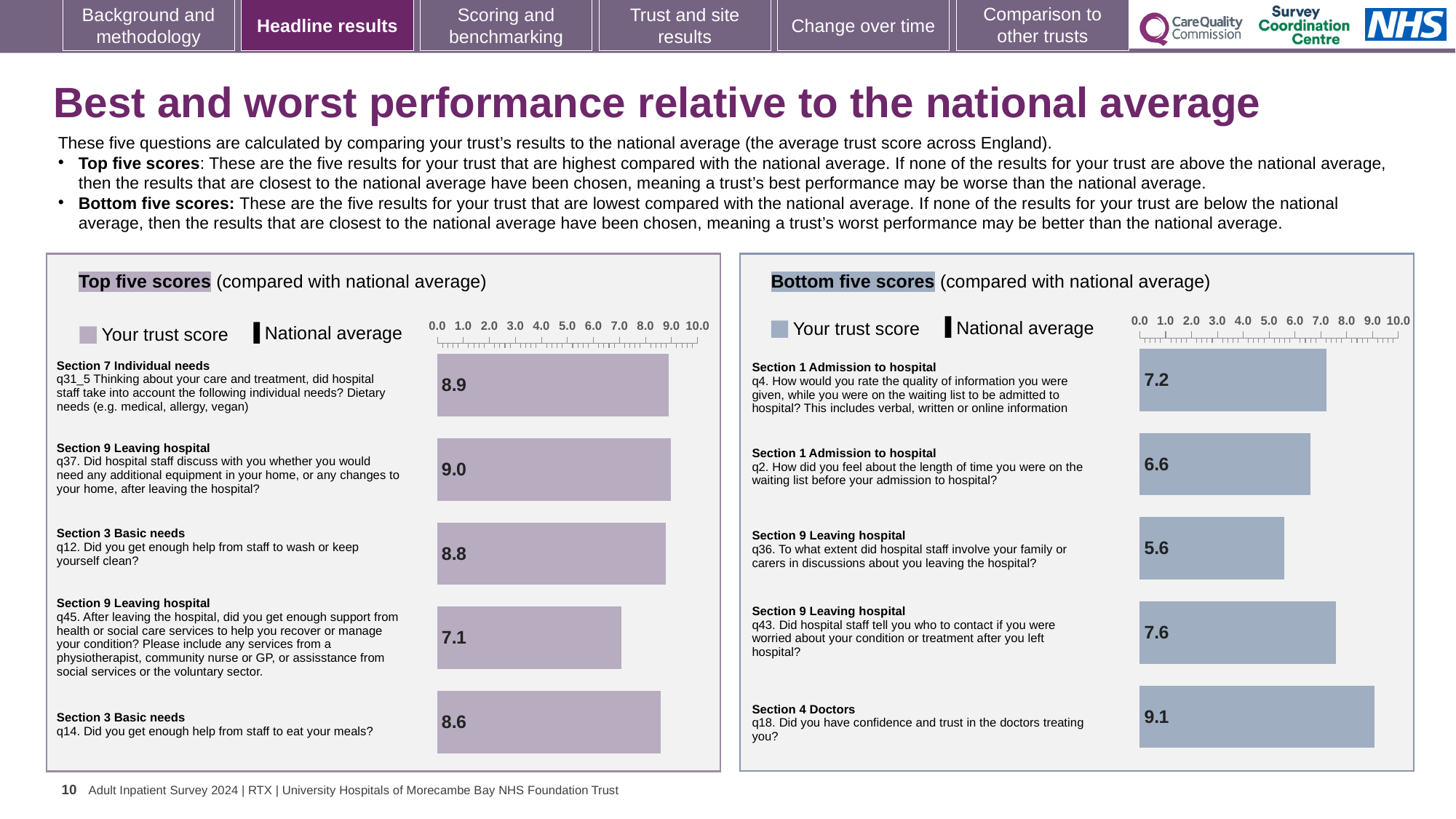
In the Bottom five scores chart, what is the difference between the trust scores for q18 and q36? 3.5 In the Bottom five scores chart, which question has the highest trust score? q18 (9.1) In the Bottom five scores chart, which question has the lowest trust score? q36 (5.6) How many bars are shown in the Top five scores chart? 5 In the Top five scores chart, what is the trust score for q37 (Did hospital staff discuss with you whether you would need any additional equipment in your home)? 9.0 In the Bottom five scores chart, which has the larger trust score, q4 or q43? q43 In the Top five scores chart, which question has the lowest trust score? q45 (7.1) In the Bottom five scores chart, what is the trust score for q36 (To what extent did hospital staff involve your family or carers in discussions about you leaving the hospital)? 5.6 In the Top five scores chart, what is the trust score for q14 (Did you get enough help from staff to eat your meals)? 8.6 What type of chart is used for the Bottom five scores? Bar chart In the Top five scores chart, what is the difference between the trust scores for q37 and q45? 1.9 In the Top five scores chart, which question has the highest trust score? q37 (9.0)